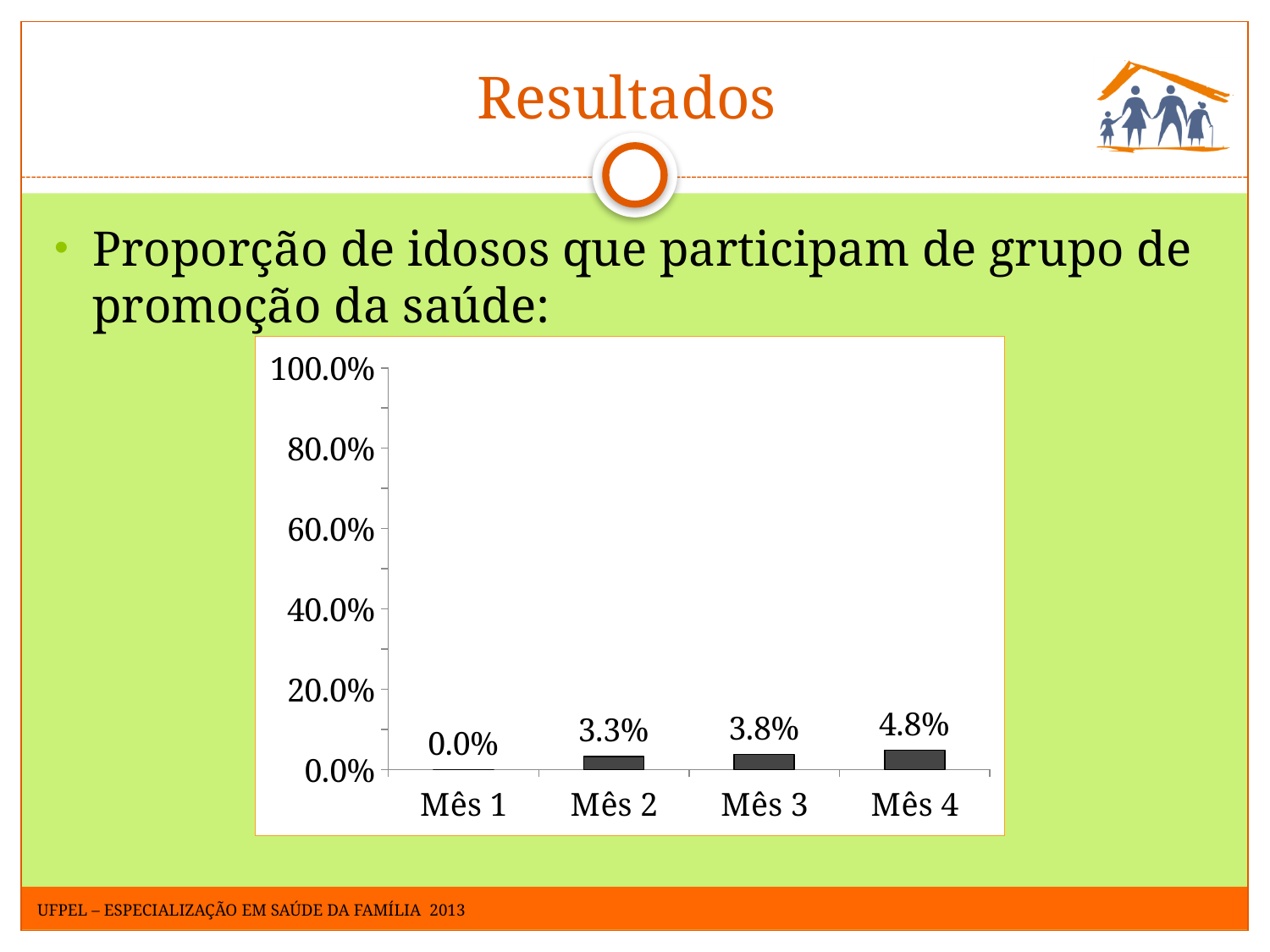
What is the value for Mês 4? 4.8% What is the value for Mês 3? 3.8% Which is larger, the value for Mês 3 or the value for Mês 2? Mês 3 Which month has the highest value? Mês 4 What is the value for Mês 1? 0.0% What is the value for Mês 2? 3.3% How many months are shown on the x axis? 4 Do the values rise or fall from Mês 1 to Mês 4? rise What is the difference between the values for Mês 4 and Mês 2? 1.5% What kind of chart is shown on the slide? bar chart Is the value for Mês 4 greater or less than 20.0%? less Which month has the lowest value? Mês 1